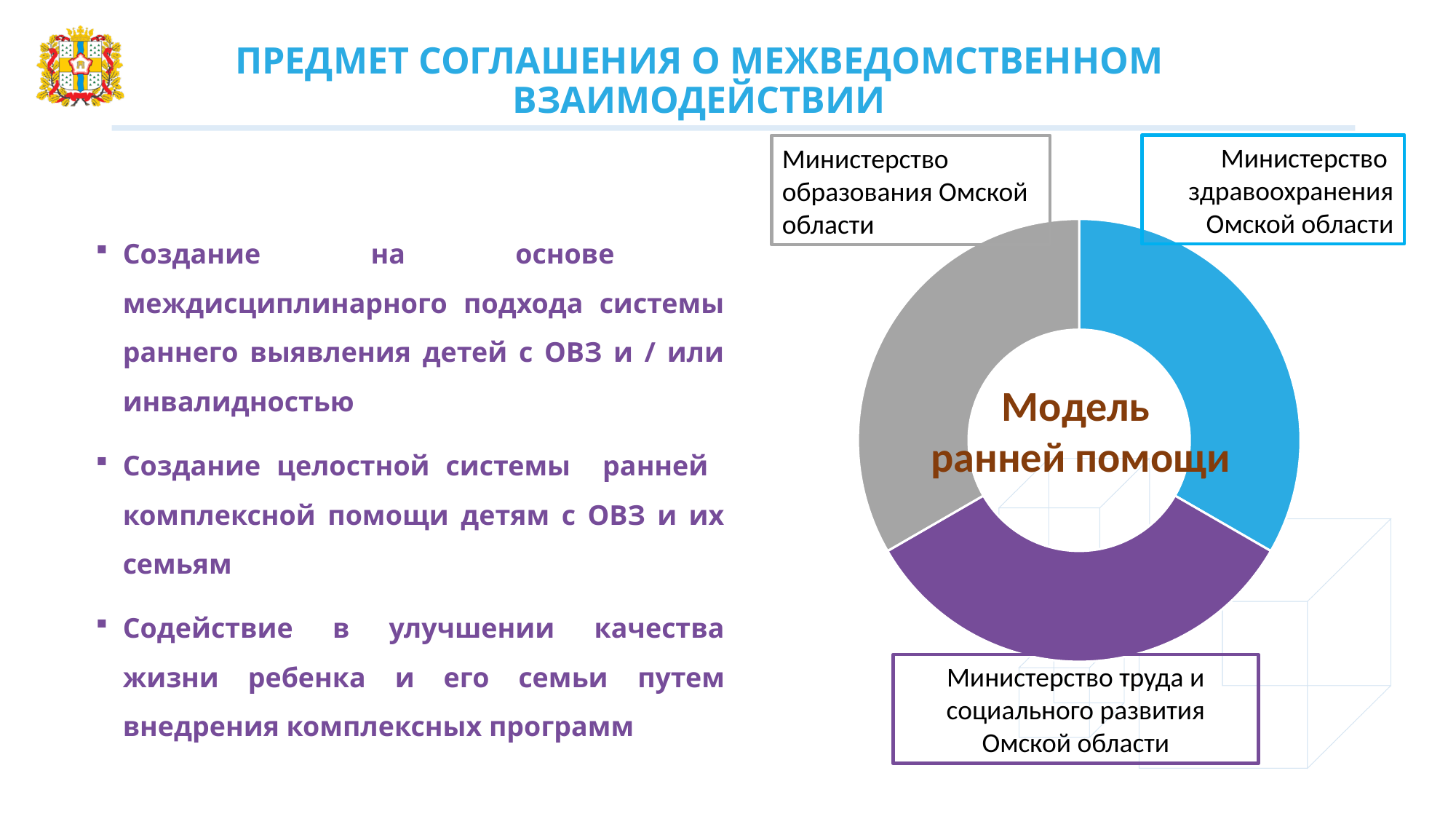
What text is written in the centre of the doughnut chart? Модель ранней помощи How many segments does the doughnut chart have? 3 Which ministry is associated with the grey segment of the doughnut chart? Министерство образования Омской области Which ministry is associated with the purple segment of the doughnut chart? Министерство труда и социального развития Омской области Which colour is the segment labelled "Министерство здравоохранения Омской области"? blue How many ministries are labelled around the doughnut chart? 3 What kind of chart is shown on the right side of the slide? doughnut chart